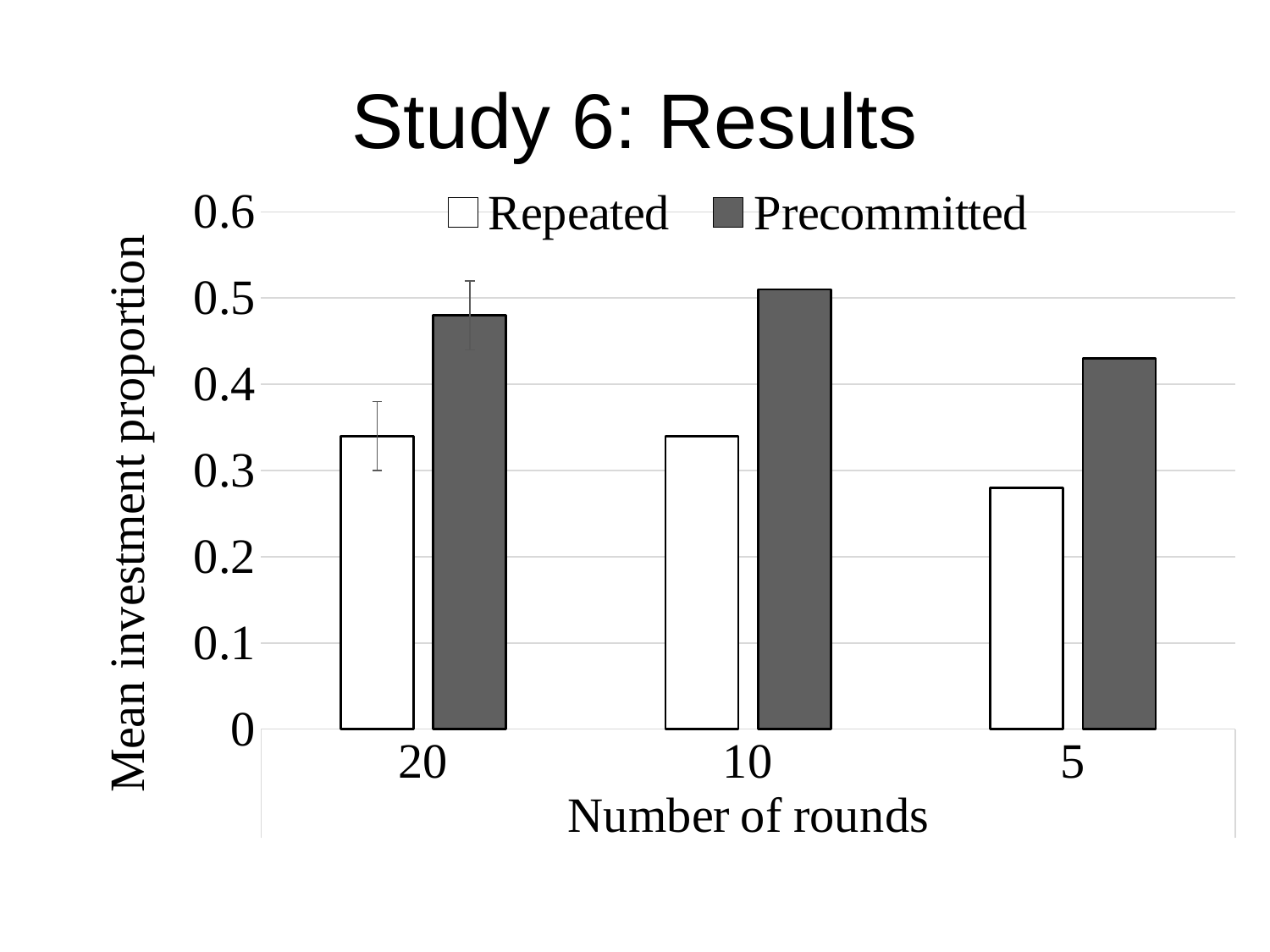
For 5 rounds, which series has the larger value, Repeated or Precommitted? Precommitted Is the Repeated value for 20 rounds greater or less than 0.3? greater How many series does the legend list? 2 How many categories are shown on the x axis? 3 For which number of rounds is the Repeated value lowest? 5 Is the Precommitted value for 20 rounds greater or less than 0.5? less What kind of chart is shown on the slide? Bar chart Is the Precommitted value for 5 rounds greater or less than 0.4? greater For which number of rounds is the Precommitted value highest? 10 What is the label of the y axis? Mean investment proportion